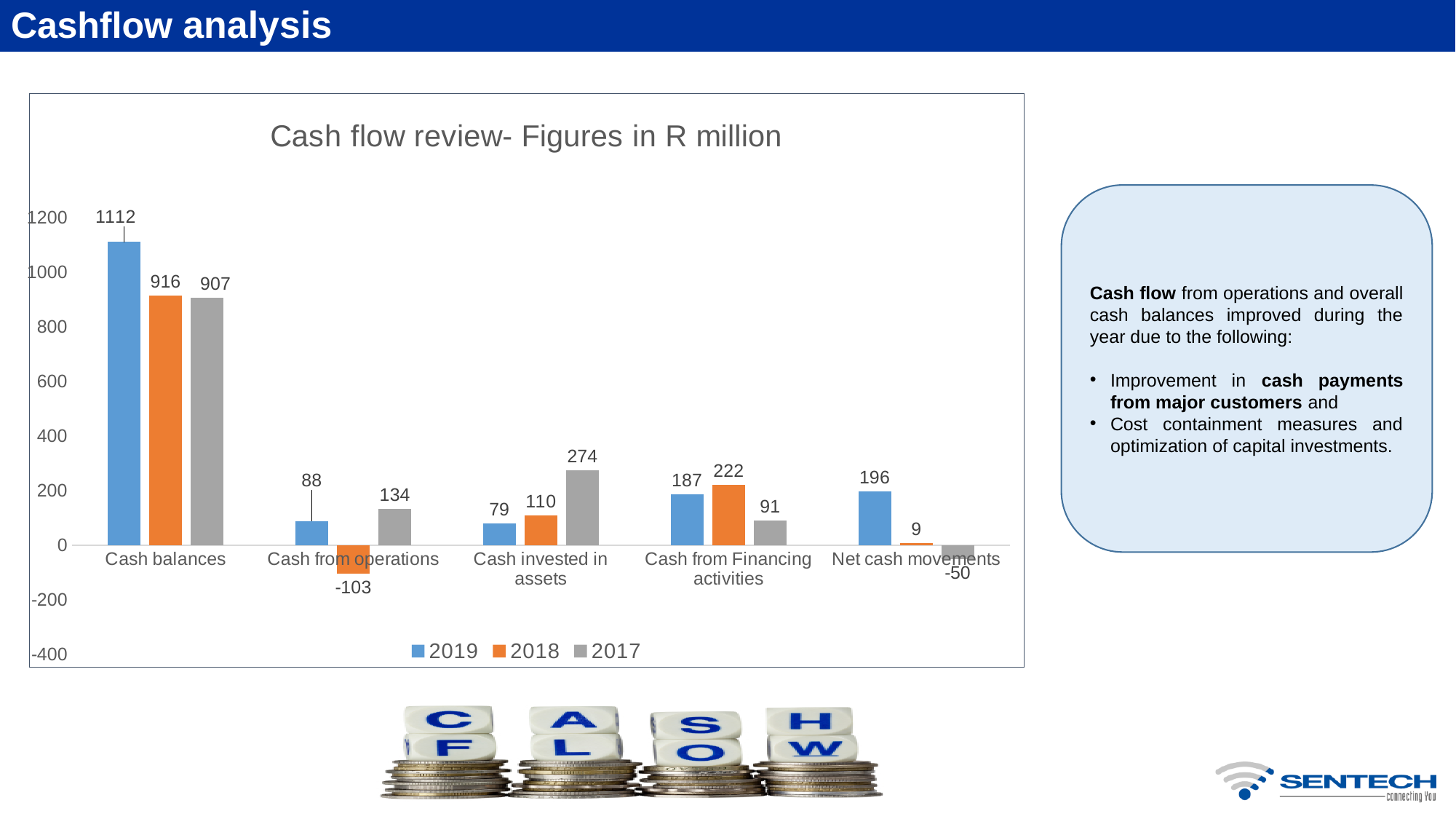
What is the 2019 value for Cash balances? 1112 What kind of chart is shown? Bar chart Which is larger for Cash from Financing activities: the 2019 value or the 2018 value? 2018 What is the 2017 value for Cash invested in assets? 274 What is the difference between the 2019 and 2018 values for Cash balances? 196 How many series does the legend list? 3 What is the 2018 value for Cash from operations? -103 Which category has the lowest 2018 value? Cash from operations What is the title of the chart? Cash flow review- Figures in R million How many categories are shown on the x axis? 5 Which category has the highest 2019 value? Cash balances What is the 2018 value for Net cash movements? 9